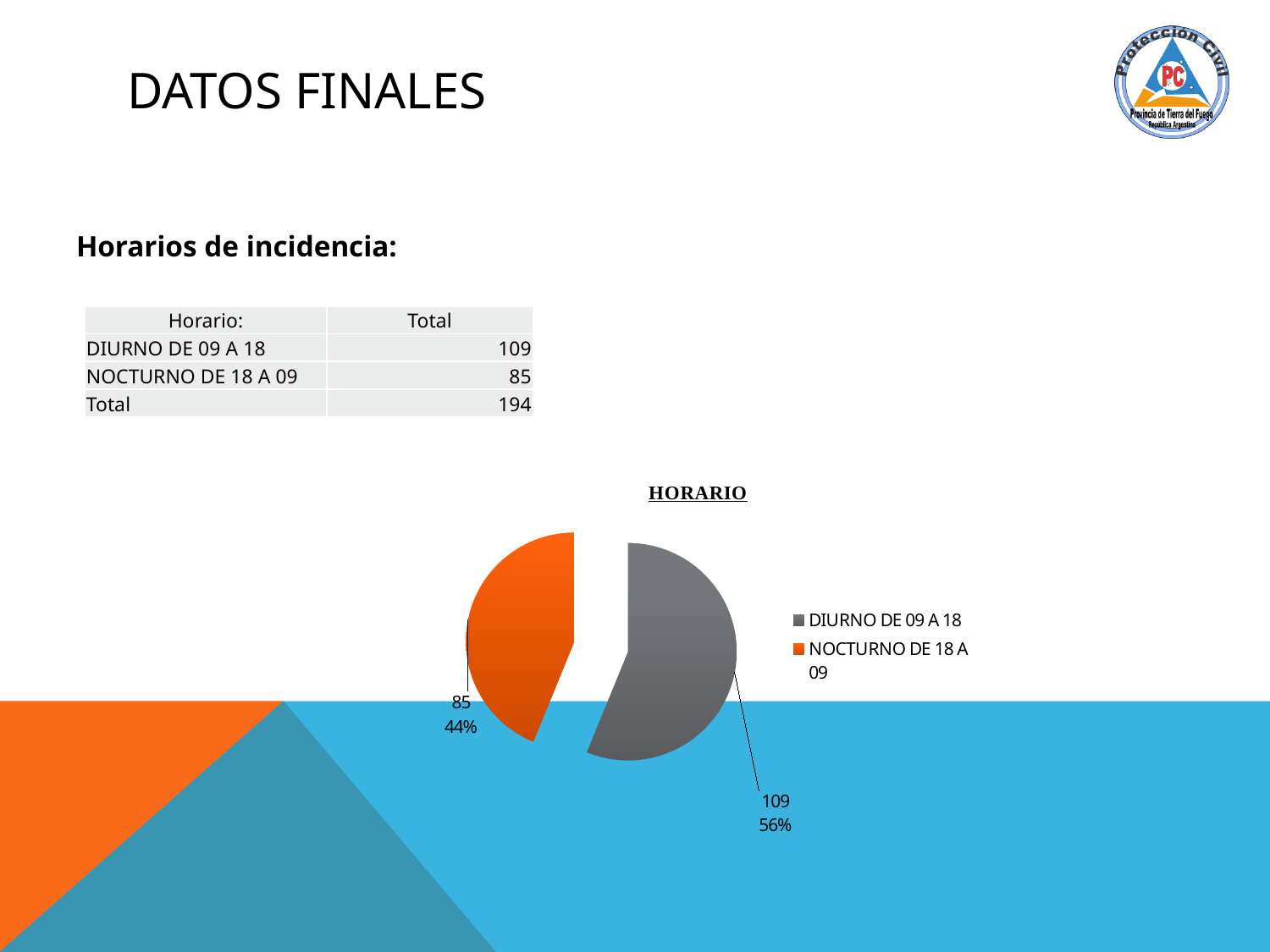
What is the value for NOCTURNO DE 18 A 09 in the HORARIO pie chart? 85 What percentage share does the DIURNO DE 09 A 18 slice have in the HORARIO pie chart? 56% What percentage share does the NOCTURNO DE 18 A 09 slice have in the HORARIO pie chart? 44% Which category has the largest slice in the HORARIO pie chart? DIURNO DE 09 A 18 Which category has the smallest slice in the HORARIO pie chart? NOCTURNO DE 18 A 09 What kind of chart is shown under the title HORARIO? pie chart What is the difference between the DIURNO DE 09 A 18 and NOCTURNO DE 18 A 09 values in the HORARIO pie chart? 24 What is the total of the two values shown in the HORARIO pie chart? 194 What colour is the NOCTURNO DE 18 A 09 slice in the HORARIO pie chart? orange How many slices does the HORARIO pie chart have? 2 Which is larger in the HORARIO pie chart, DIURNO DE 09 A 18 or NOCTURNO DE 18 A 09? DIURNO DE 09 A 18 What is the value for DIURNO DE 09 A 18 in the HORARIO pie chart? 109